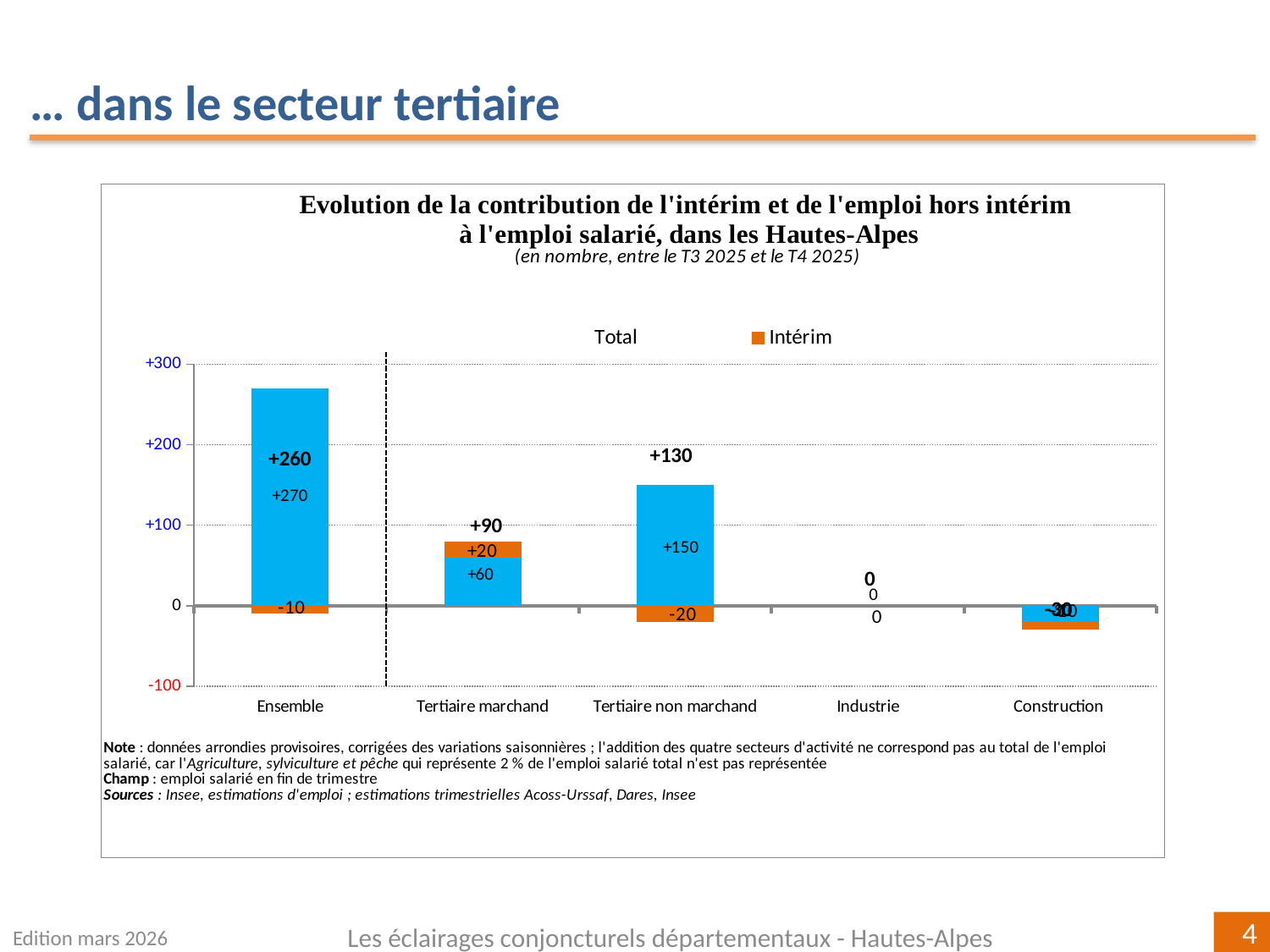
What kind of chart is shown on the slide? bar chart Which has the larger Total value, Tertiaire marchand or Tertiaire non marchand? Tertiaire non marchand What is the Intérim value for Tertiaire non marchand? -20 What is the Intérim value for Tertiaire marchand? +20 Which département does the chart title say the data is for? Hautes-Alpes Which category has the highest Total value? Ensemble How many sector categories are shown on the x axis? 5 What is the Total value for Tertiaire non marchand? +130 What is the Intérim value for Ensemble? -10 What is the Total value for Industrie? 0 What is the Total value for Ensemble? +260 What is the difference between the Total values for Ensemble and Tertiaire non marchand? 130